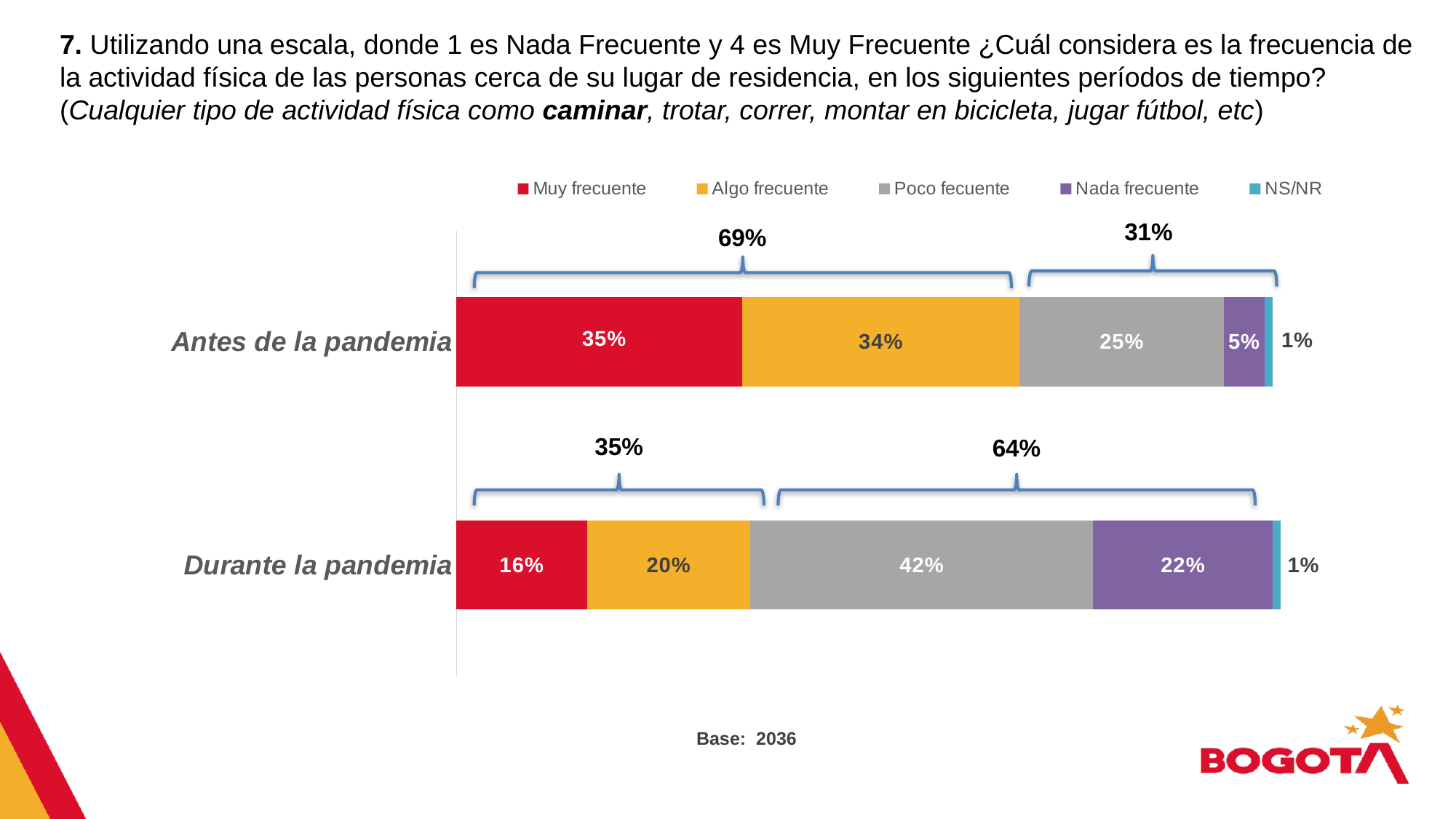
What is the value for Muy frecuente in the Antes de la pandemia bar? 35% What is the difference between the Muy frecuente values for Antes de la pandemia and Durante la pandemia? 19% What is the value for Algo frecuente in the Durante la pandemia bar? 20% What is the combined share of Muy frecuente and Algo frecuente for Antes de la pandemia, as shown by the bracket label? 69% What kind of chart is shown on the slide? Stacked bar chart Which series has the smallest segment in the Antes de la pandemia bar? NS/NR Which series has the largest segment in the Durante la pandemia bar? Poco fecuente How many series does the legend list? 5 What is the value for Nada frecuente in the Antes de la pandemia bar? 5% What is the value for Poco fecuente in the Durante la pandemia bar? 42% How many categories (bars) does the chart show? 2 Which is larger: Nada frecuente for Antes de la pandemia or Nada frecuente for Durante la pandemia? Durante la pandemia